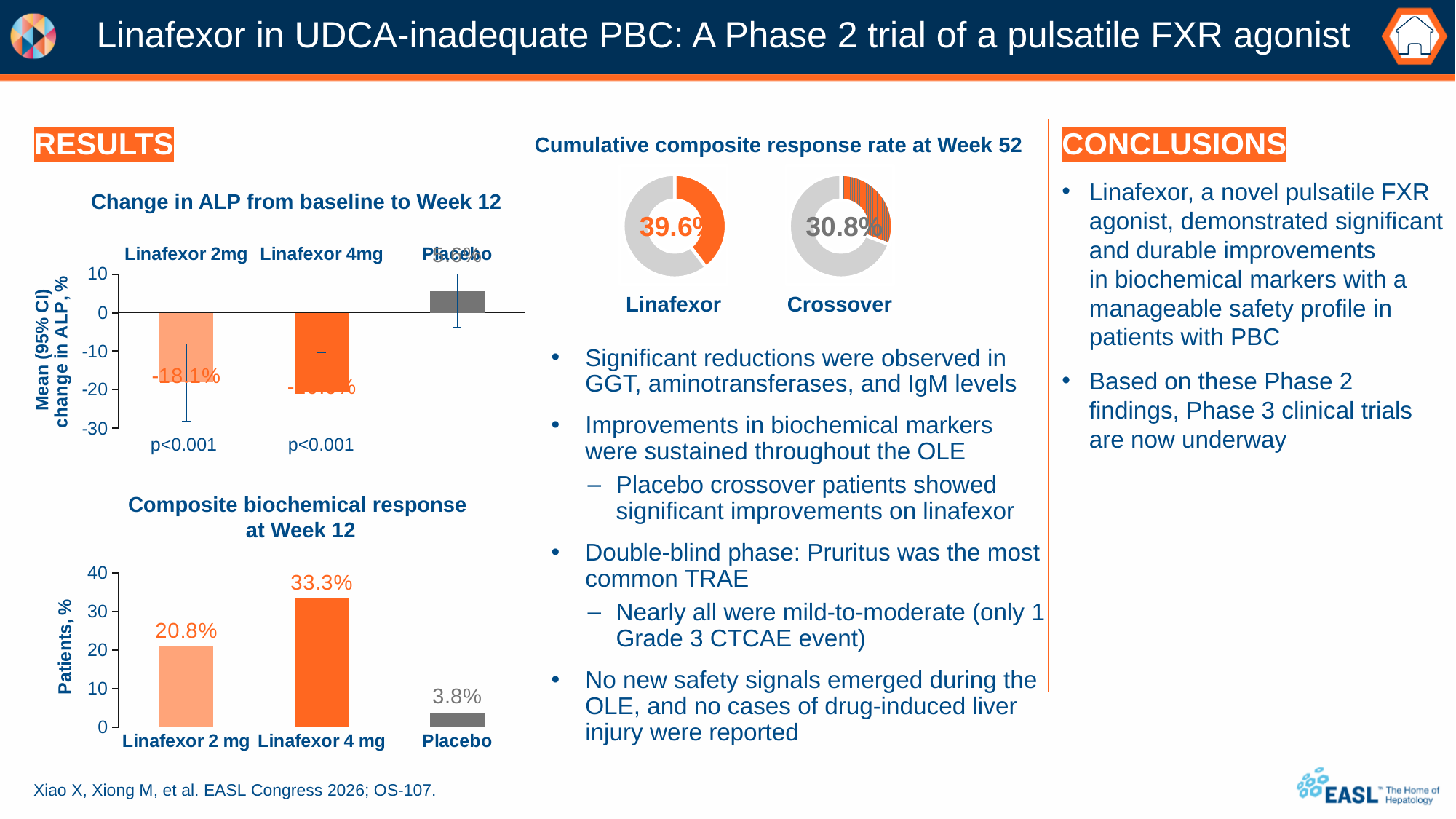
In the 'Cumulative composite response rate at Week 52' donut charts, what is the value for Linafexor? 39.6% In the 'Composite biochemical response at Week 12' chart, how many groups are shown? 3 In the 'Composite biochemical response at Week 12' chart, what is the value for Placebo? 3.8% In the 'Change in ALP from baseline to Week 12' chart, is the value for Linafexor 4mg greater or less than -10? less In the 'Change in ALP from baseline to Week 12' chart, what is the value for Linafexor 2mg? -18.1% In the 'Composite biochemical response at Week 12' chart, which group has the highest response rate? Linafexor 4 mg In the 'Composite biochemical response at Week 12' chart, what is the value for Linafexor 4 mg? 33.3% In the 'Composite biochemical response at Week 12' chart, which group has the lowest response rate? Placebo In the 'Cumulative composite response rate at Week 52' donut charts, which is larger, Linafexor or Crossover? Linafexor In the 'Composite biochemical response at Week 12' chart, what is the difference between Linafexor 4 mg and Linafexor 2 mg? 12.5% In the 'Composite biochemical response at Week 12' chart, what is the value for Linafexor 2 mg? 20.8% What kind of chart is 'Change in ALP from baseline to Week 12'? Bar chart